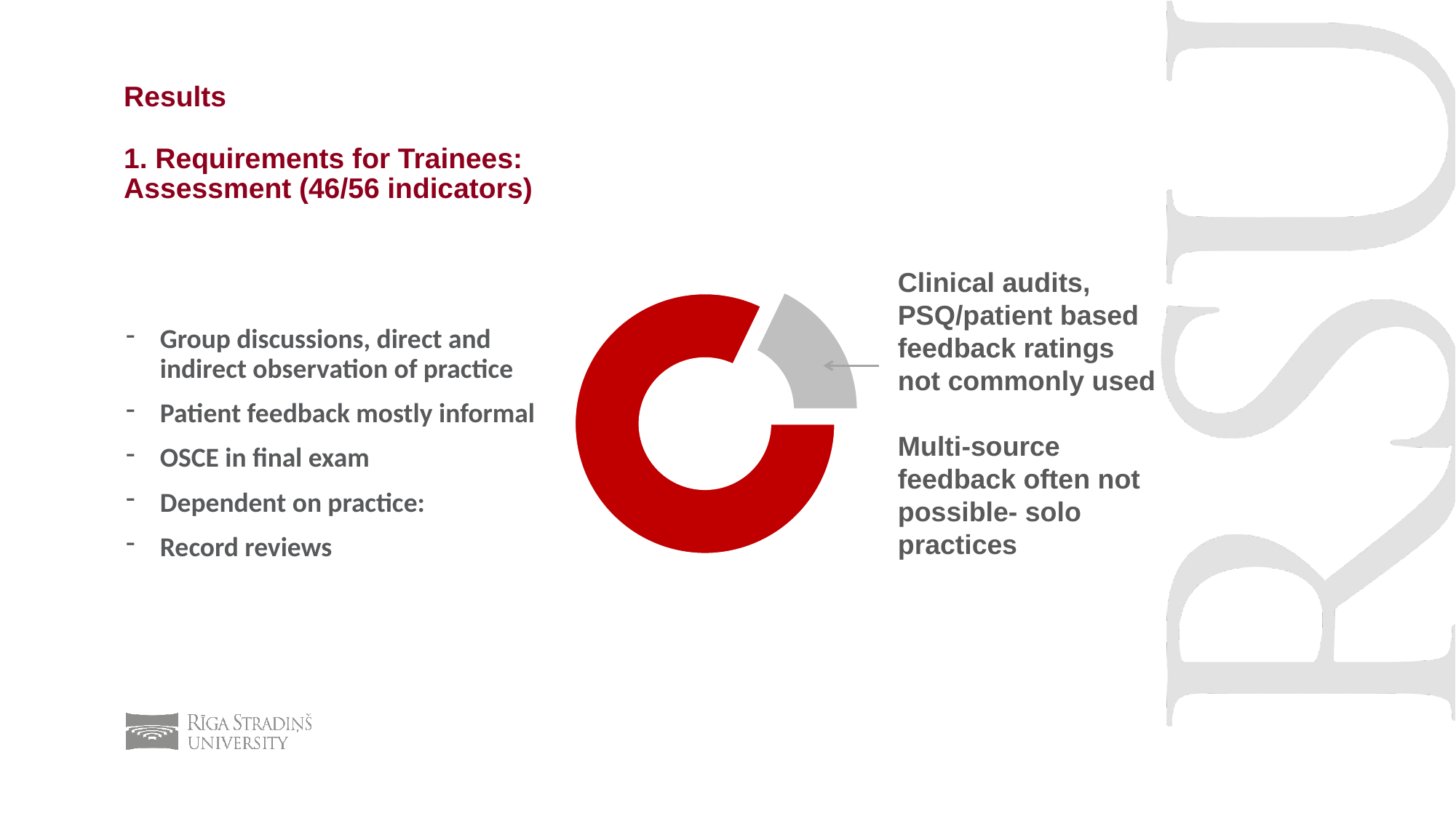
Which slice of the doughnut chart is larger, the red one or the grey one? The red one How many slices does the doughnut chart have? 2 Which text does the arrow from the grey slice of the doughnut chart point to? Clinical audits, PSQ/patient based feedback ratings not commonly used Which slice of the doughnut chart is the smallest? The grey slice What kind of chart is shown on the slide? Doughnut chart Which slice of the doughnut chart is the largest? The red slice What colour is the slice that is pulled out from the doughnut chart? Grey